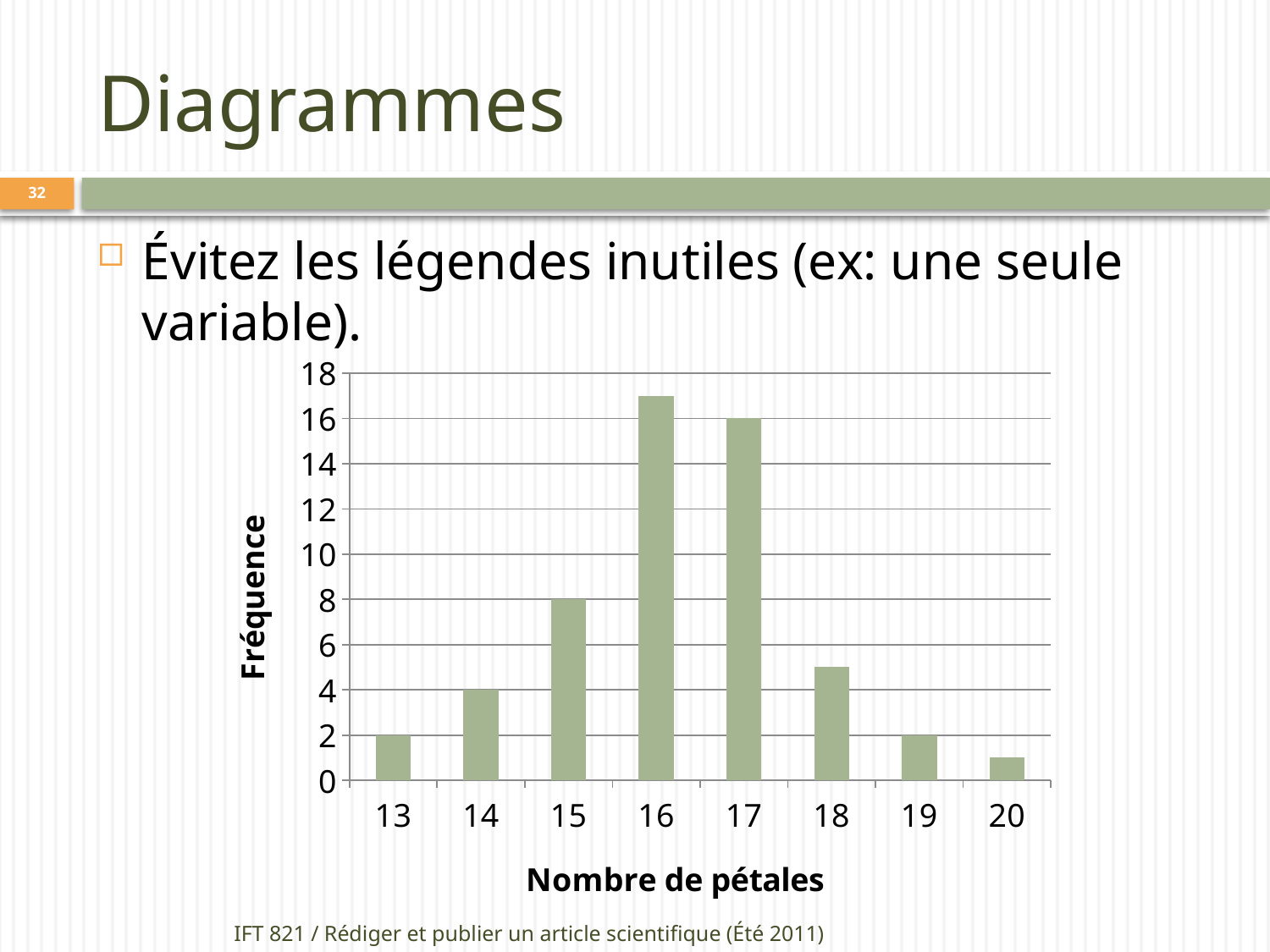
Which has a higher frequency: 15 petals or 18 petals? 15 Which number of petals has the lowest frequency? 20 What is the frequency for 17 petals? 16 Is the frequency for 16 petals greater or less than 16? greater How many petal-count categories are shown on the x axis? 8 What is the frequency for 13 petals? 2 What is the difference between the frequency for 15 petals and the frequency for 14 petals? 4 Which number of petals has the highest frequency? 16 What kind of chart is shown on the slide? bar chart What is the frequency for 14 petals? 4 What is the frequency for 15 petals (Nombre de pétales = 15)? 8 Is the frequency for 20 petals greater or less than 2? less